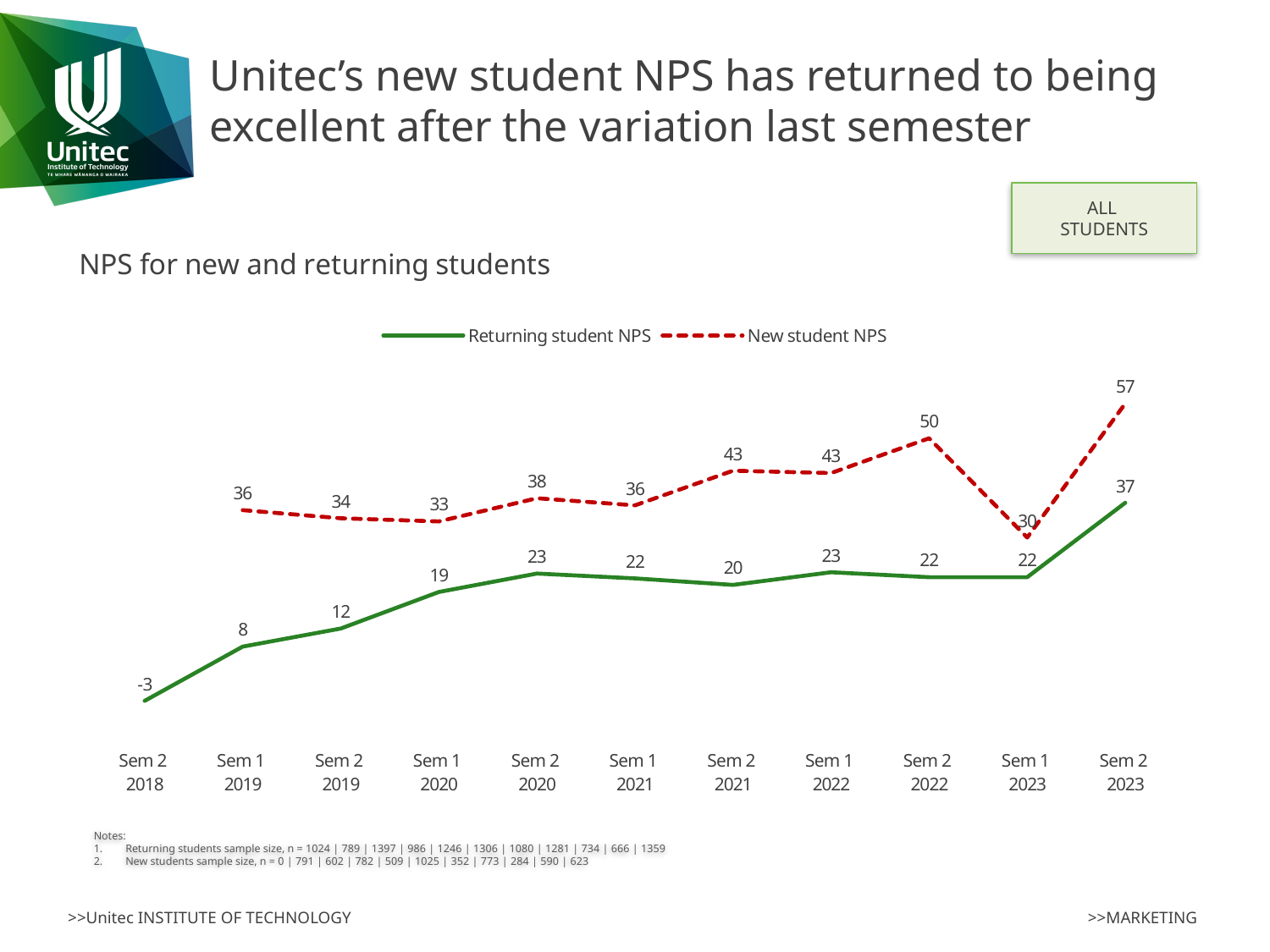
Which is larger in Sem 1 2020: the New student NPS or the Returning student NPS? New student NPS In which semester is the New student NPS highest? Sem 2 2023 What is the Returning student NPS for Sem 2 2023? 37 What is the Returning student NPS for Sem 2 2018? -3 In which semester is the Returning student NPS lowest? Sem 2 2018 How many semesters are shown on the x axis? 11 What kind of chart is shown on the slide? Line chart What is the New student NPS for Sem 2 2022? 50 How many series does the legend list? 2 Which series is drawn with a dashed red line? New student NPS What is the difference between the New student NPS and the Returning student NPS in Sem 2 2023? 20 What is the New student NPS for Sem 1 2023? 30